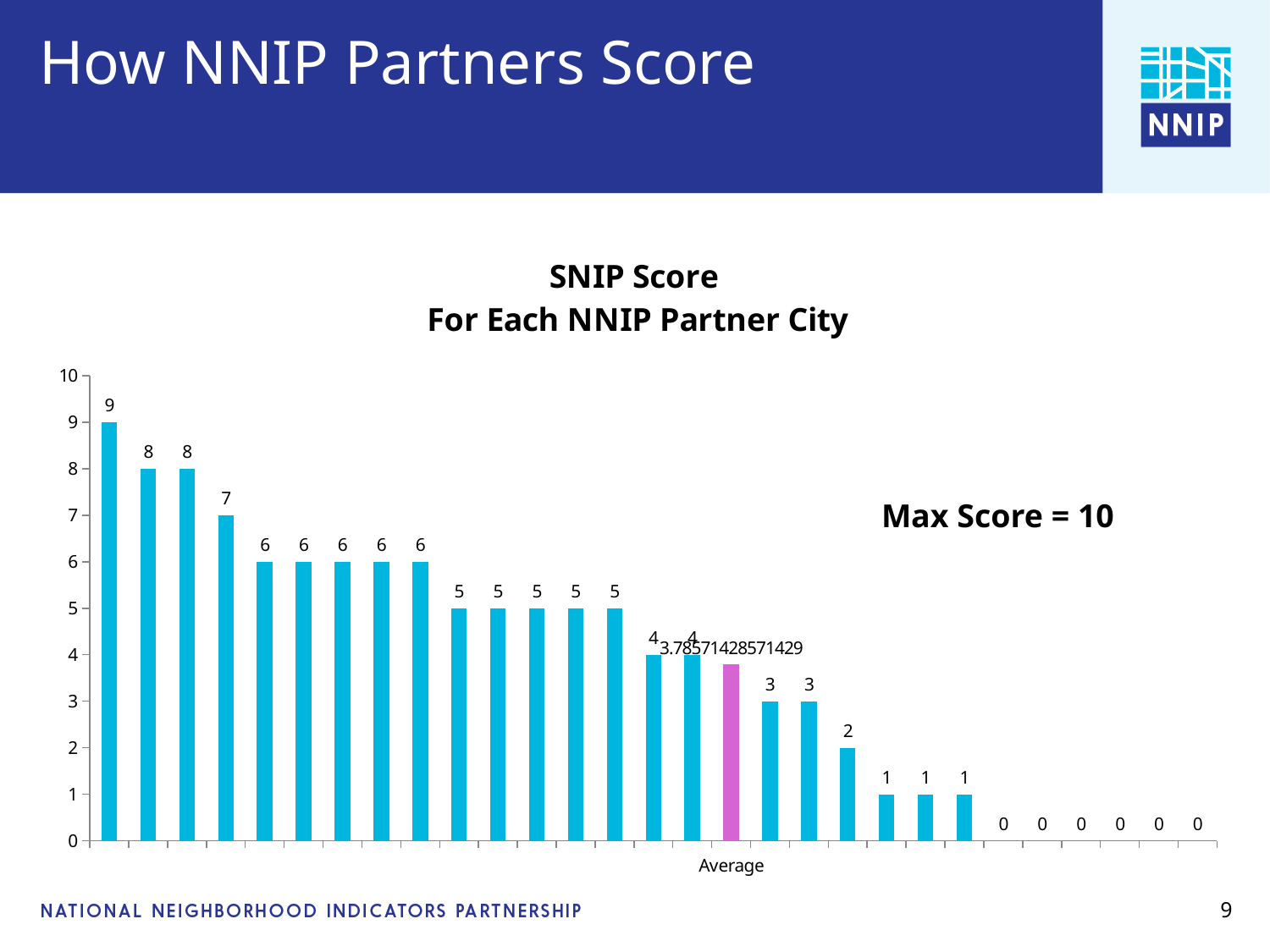
How many bars on the chart have a value of 0? 6 How many bars on the chart have a value of 5? 5 Is the value of the Average bar greater or less than 4? less What kind of chart is shown on the slide? bar chart How many bars are plotted on the chart in total, including the Average bar? 29 What is the highest score shown on the chart? 9 What is the value of the bar labeled "Average"? 3.78571428571429 What colour is the Average bar on the chart? pink/purple What is the difference between the highest score (9) and the lowest score (0) on the chart? 9 Do the bar values rise or fall from left to right along the x axis? fall What is the lowest score shown on the chart? 0